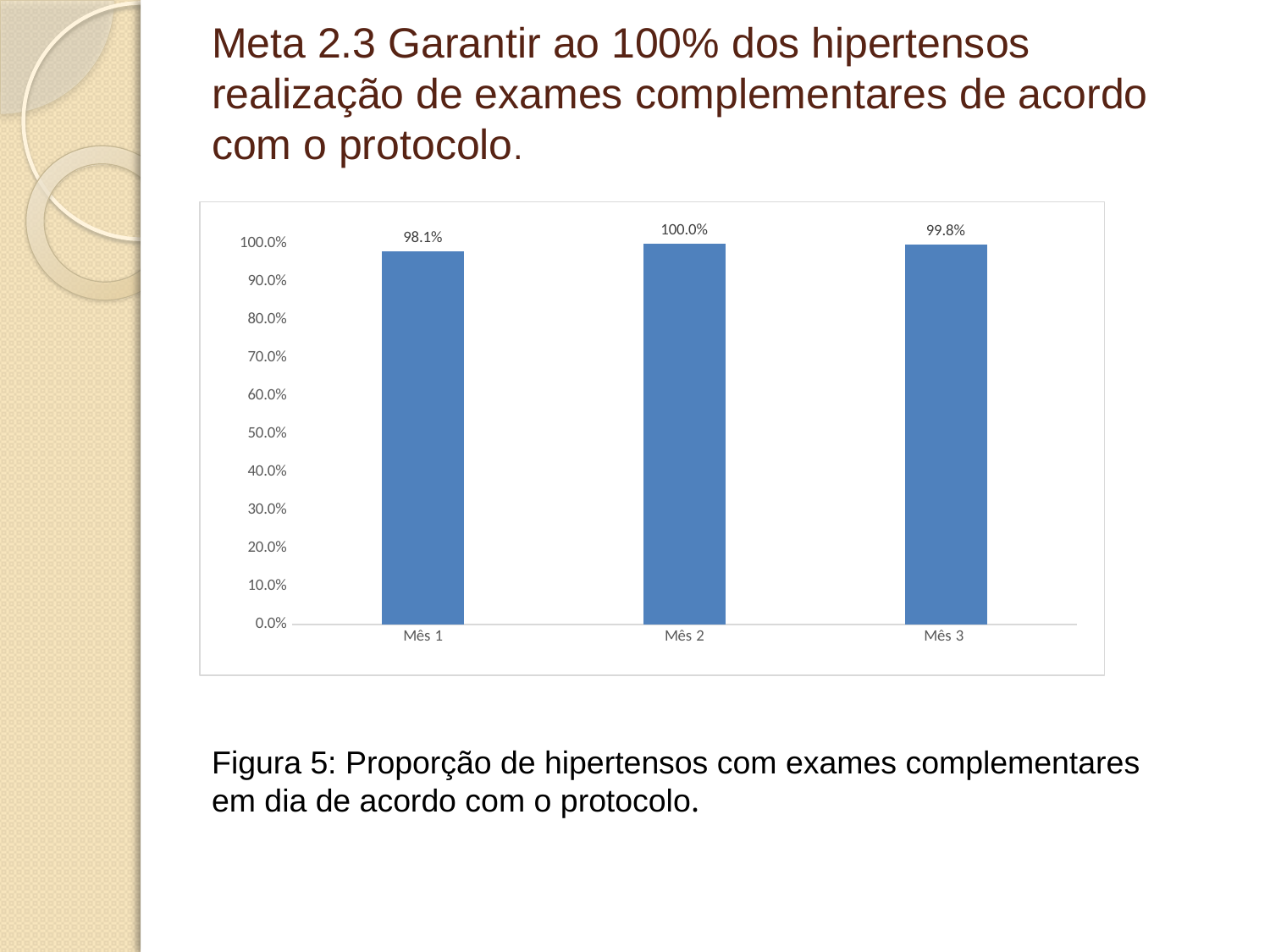
What kind of chart is shown on the slide? bar chart How many months are shown on the x axis? 3 What is the difference between the values for Mês 3 and Mês 1? 1.7% What is the difference between the values for Mês 2 and Mês 1? 1.9% What is the value for Mês 1? 98.1% What is the value for Mês 3? 99.8% What is the caption given for the figure below the chart? Figura 5: Proporção de hipertensos com exames complementares em dia de acordo com o protocolo. Is the value for Mês 1 greater or less than 90.0%? greater What is the value for Mês 2? 100.0% Which month has the lowest value? Mês 1 Which month has the highest value? Mês 2 Which is larger, the value for Mês 1 or the value for Mês 3? Mês 3